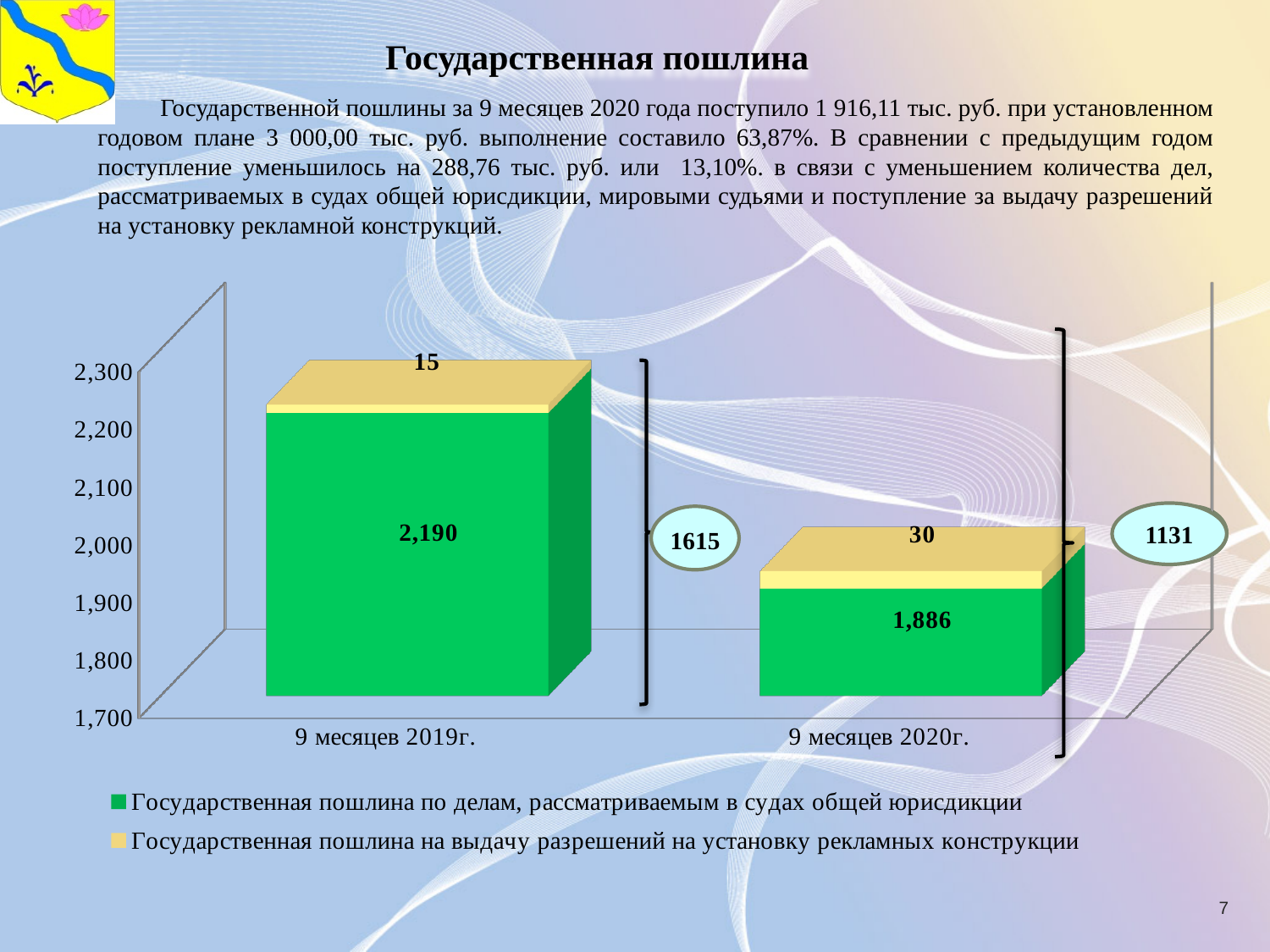
What is the value of 'Государственная пошлина по делам, рассматриваемым в судах общей юрисдикции' for '9 месяцев 2020г.'? 1,886 Which colour represents 'Государственная пошлина на выдачу разрешений на установку рекламных конструкции' in the chart? yellow What is the value of 'Государственная пошлина на выдачу разрешений на установку рекламных конструкции' for '9 месяцев 2019г.'? 15 How many series does the chart legend list? 2 How many categories are shown on the x axis of the chart? 2 What is the total of the stacked bar for '9 месяцев 2020г.'? 1,916 What is the value of 'Государственная пошлина по делам, рассматриваемым в судах общей юрисдикции' for '9 месяцев 2019г.'? 2,190 Which category has the higher value for 'Государственная пошлина по делам, рассматриваемым в судах общей юрисдикции'? 9 месяцев 2019г. Does the value for 'Государственная пошлина на выдачу разрешений на установку рекламных конструкции' rise or fall from '9 месяцев 2019г.' to '9 месяцев 2020г.'? rise What is the value of 'Государственная пошлина на выдачу разрешений на установку рекламных конструкции' for '9 месяцев 2020г.'? 30 What is the difference between the 'Государственная пошлина по делам, рассматриваемым в судах общей юрисдикции' values for '9 месяцев 2019г.' and '9 месяцев 2020г.'? 304 What type of chart is shown on the slide? bar chart